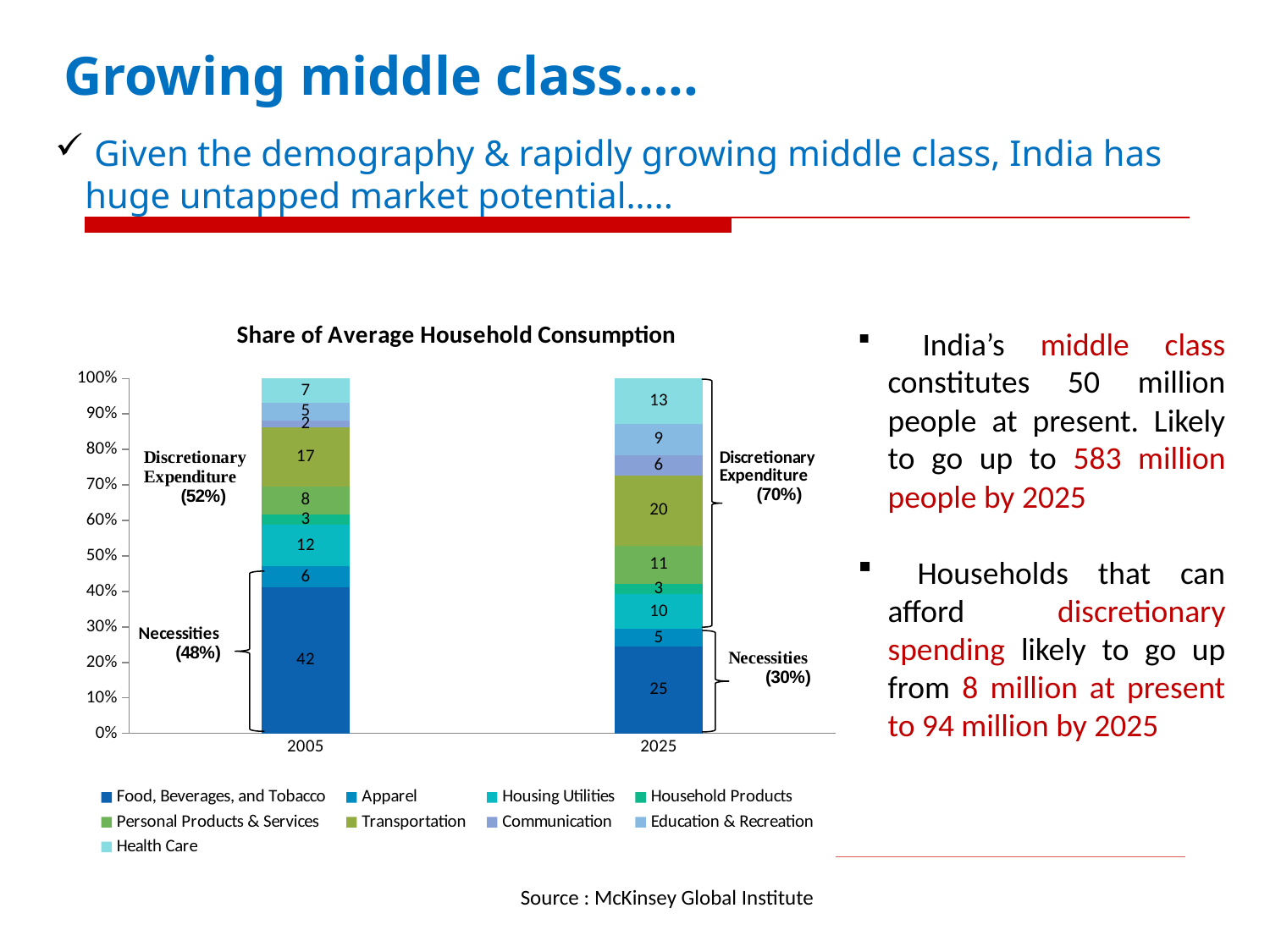
What is the value for Housing Utilities in 2005? 12 How many years (categories) are shown on the x axis? 2 What share of consumption is labelled as Necessities for 2025? 30% Which year has the larger Transportation value, 2005 or 2025? 2025 What is the value for Transportation in 2025? 20 What is the title of the chart? Share of Average Household Consumption What is the value for Health Care in 2025? 13 Which segment is the largest in the 2025 bar? Food, Beverages, and Tobacco By how much does the Food, Beverages, and Tobacco value fall from 2005 to 2025? 17 What kind of chart is shown? Stacked bar chart What is the value for Food, Beverages, and Tobacco in 2005? 42 How many series does the legend list? 9